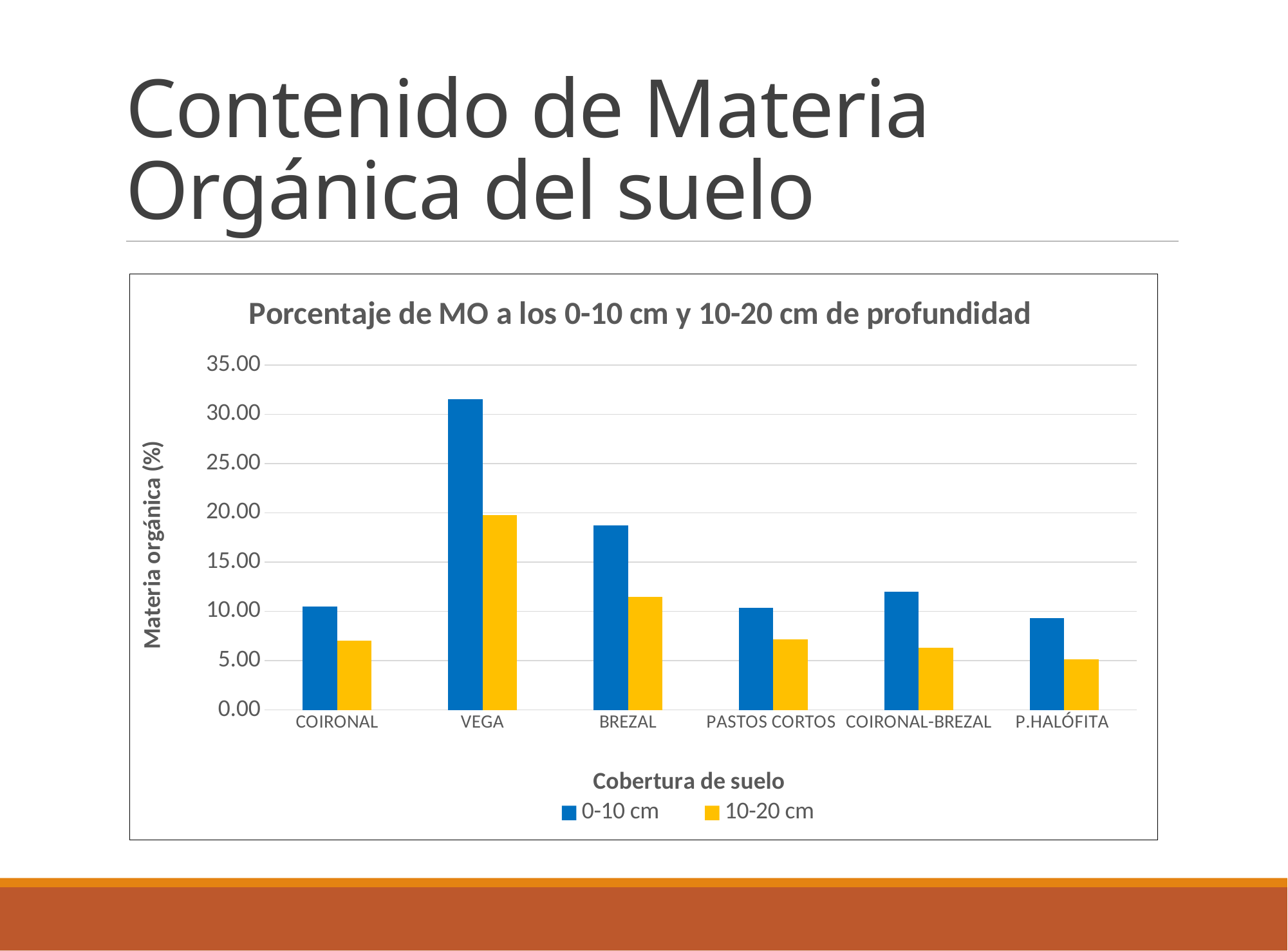
Is the 10-20 cm value for BREZAL greater or less than 10.00? greater Is the 0-10 cm value for VEGA greater or less than 30.00? greater Is the 0-10 cm value for BREZAL greater or less than 20.00? less How many series does the legend list? 2 Which soil cover has the highest value for the 0-10 cm series? VEGA Which is larger: the 0-10 cm value for BREZAL or the 0-10 cm value for COIRONAL-BREZAL? BREZAL What kind of chart is shown on the slide? bar chart Which soil cover has the highest value for the 10-20 cm series? VEGA What is the label of the y axis? Materia orgánica (%) Which soil cover has the lowest value for the 0-10 cm series? P.HALÓFITA How many soil cover categories are shown on the x axis? 6